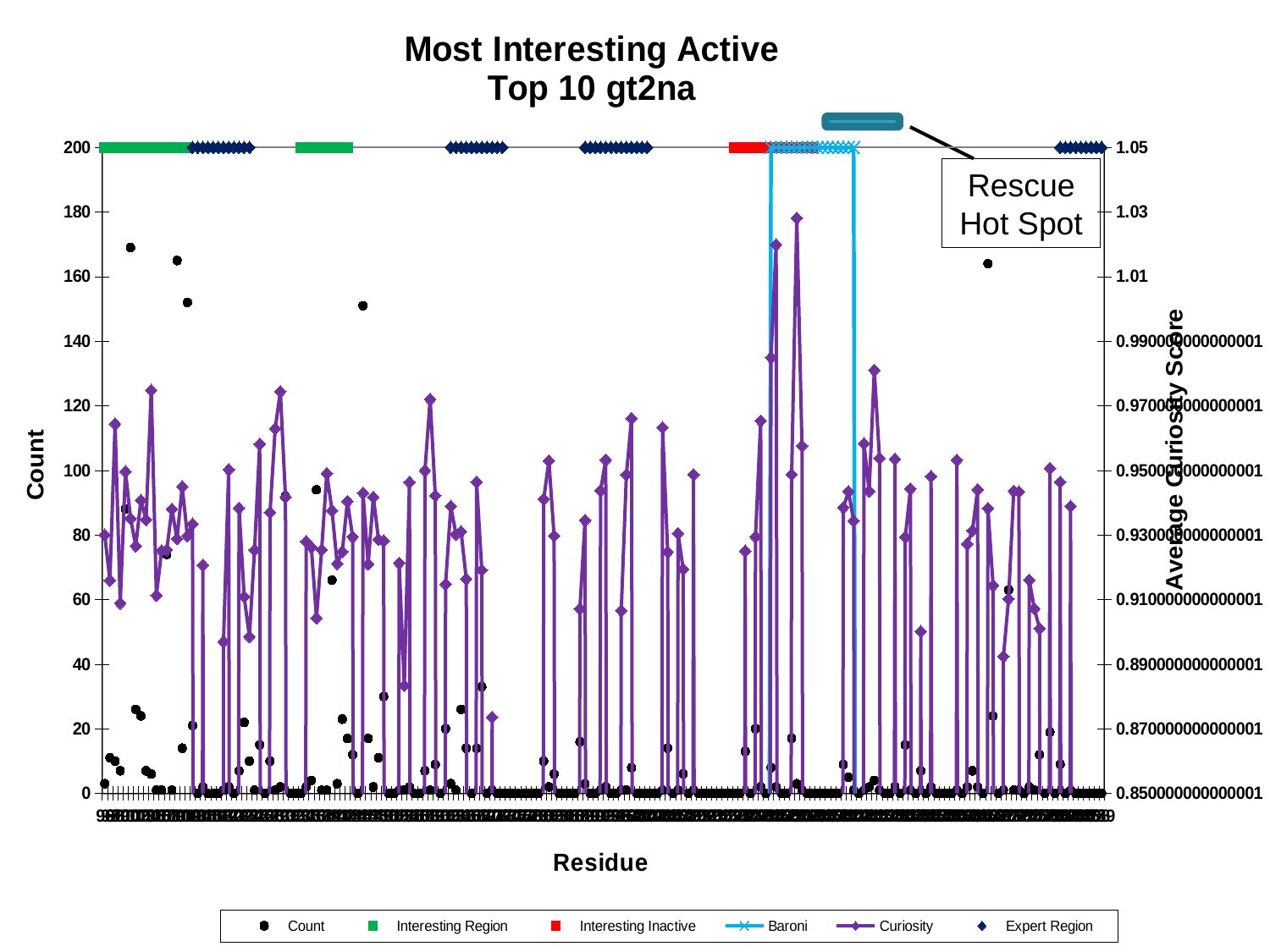
What text appears in the callout box pointing to the highlighted region near the top of the chart? Rescue Hot Spot Is the highest Count point on the chart greater or less than 180? less How many series does the legend list? 6 What is the label of the x axis? Residue What is the highest tick value shown on the right axis? 1.05 What is the title of the right vertical axis? Average Curiosity Score Is the highest Count point on the chart greater or less than 160? greater Which series in the legend is drawn as a purple line with diamond markers? Curiosity What is the highest tick value shown on the left Count axis? 200 What is the title of the left vertical axis? Count Is the peak of the Curiosity line greater or less than 1.01 on the right axis? greater What is the title of the chart? Most Interesting Active Top 10 gt2na